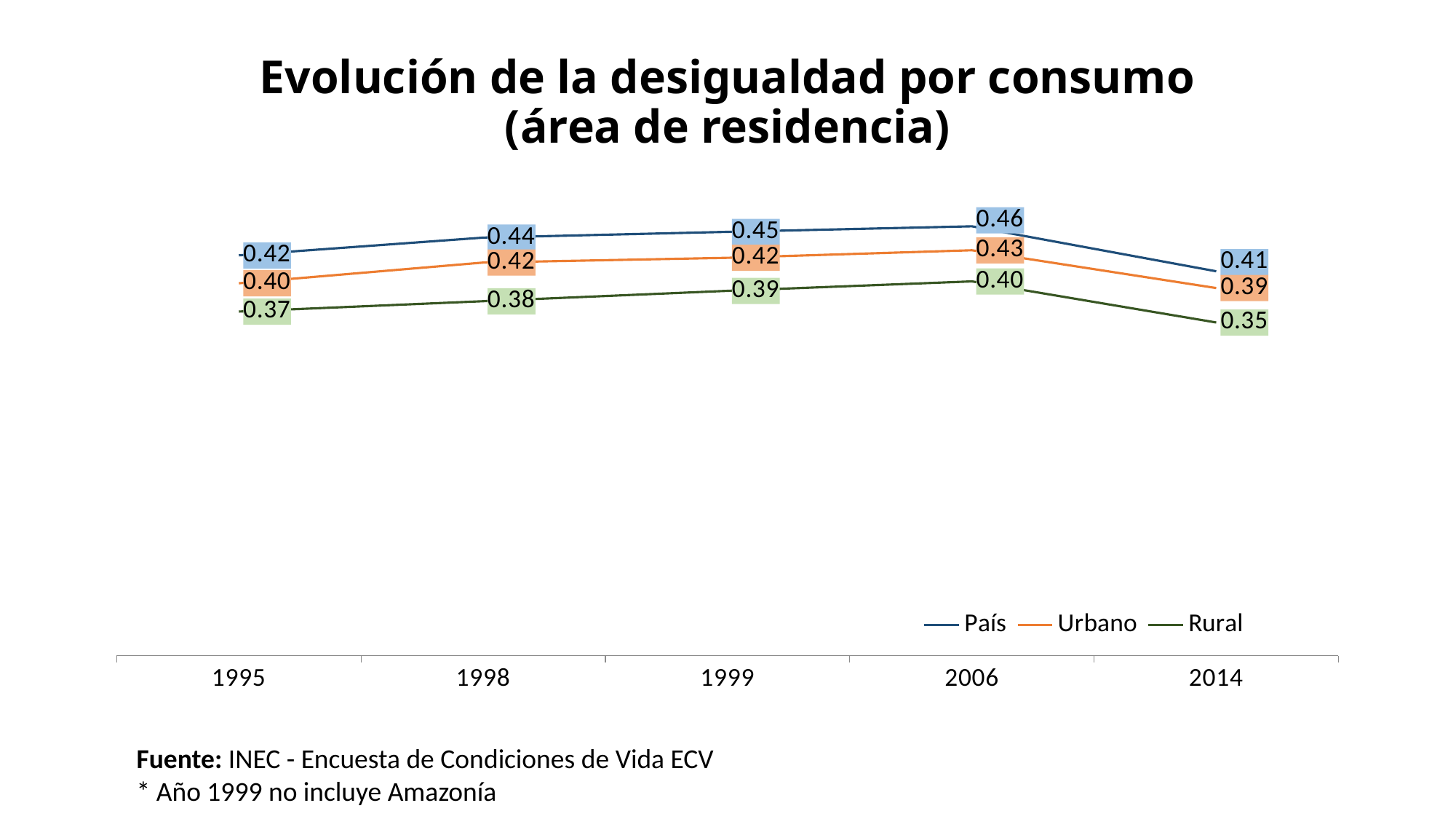
What kind of chart is shown on the slide? Line chart What is the difference between the País and Rural values in 2014? 0.06 How many series does the legend list? 3 How many years are shown on the x axis? 5 What is the title of the chart? Evolución de la desigualdad por consumo (área de residencia) What is the value for Urbano in 1998? 0.42 What is the value for Rural in 2014? 0.35 Which is larger in 1995, the Urbano value or the Rural value? Urbano Does the Urbano series rise or fall between 2006 and 2014? Fall What is the value for País in 2006? 0.46 In which year is the País series highest? 2006 In which year is the Rural series lowest? 2014